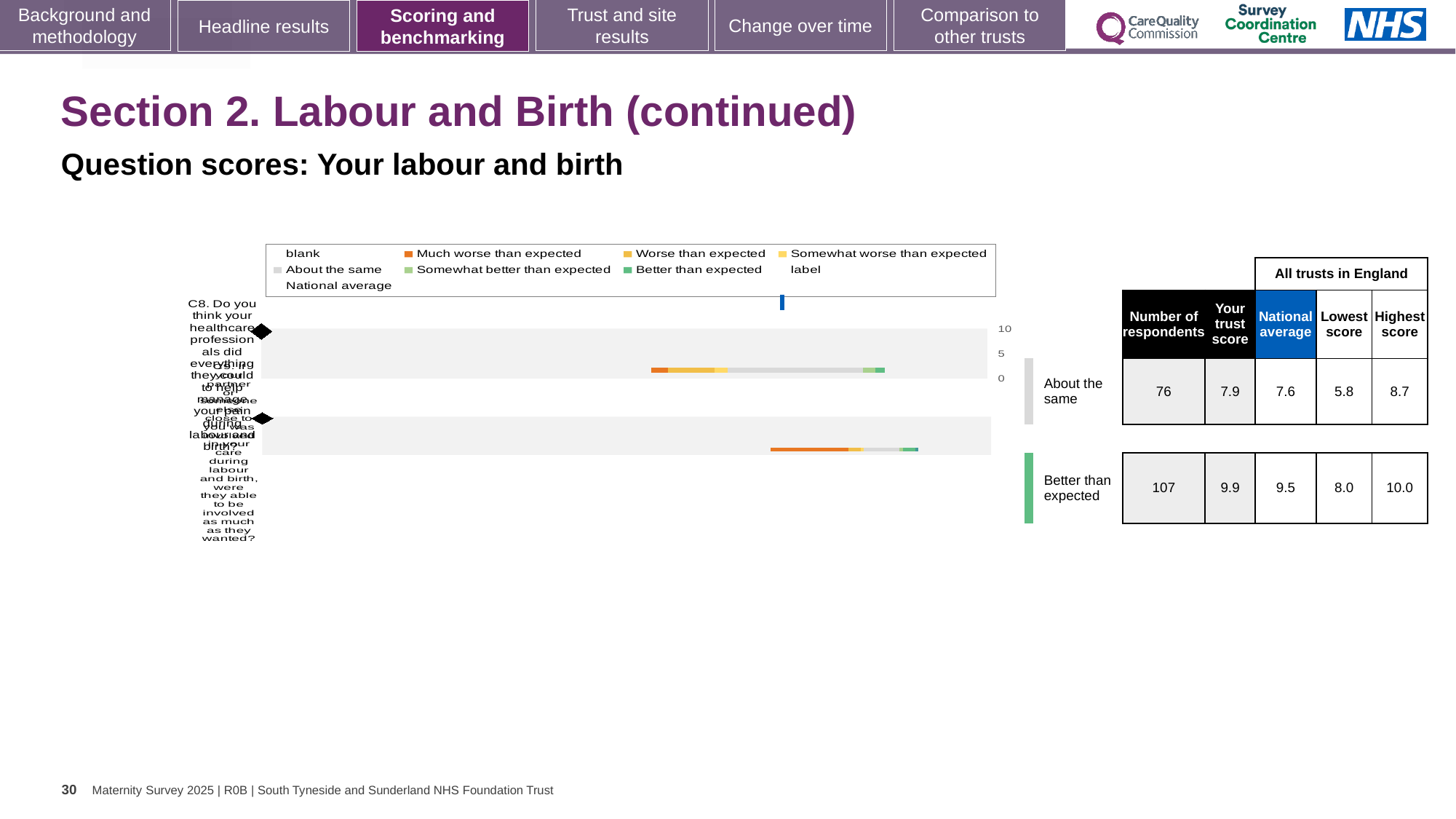
In the table beside the chart, which row has more respondents, 'About the same' or 'Better than expected'? Better than expected In the table beside the chart, what is the difference in number of respondents between the 'Better than expected' and 'About the same' rows? 31 In the table beside the chart, what is the difference between the trust score and the national average for the 'Better than expected' row? 0.4 In the table beside the chart, what is the trust score for the 'Better than expected' row? 9.9 What kind of chart is shown on the slide? bar chart How many question rows (bars) are plotted in the chart? 2 In the table beside the chart, what is the national average for the 'About the same' row? 7.6 In the chart legend, what colour represents 'Much worse than expected'? orange In the table beside the chart, what is the highest score among all trusts in England for the 'Better than expected' row? 10.0 What is the highest tick value shown on the chart's axis? 10 In the table beside the chart, what is the number of respondents for the 'About the same' row? 76 In the table beside the chart, what is the lowest score among all trusts in England for the 'About the same' row? 5.8